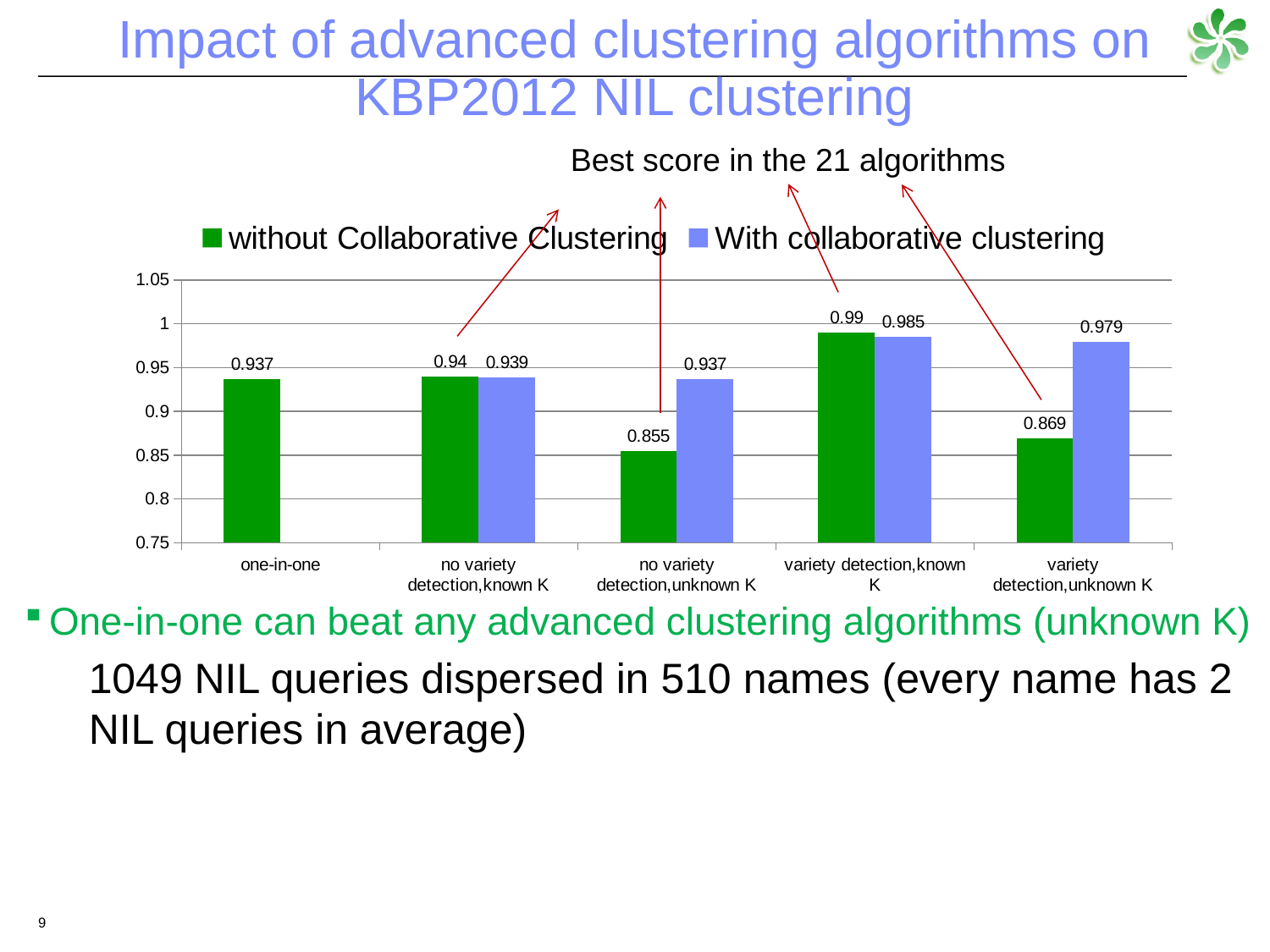
What is the value for no variety detection,unknown K with collaborative clustering? 0.937 How many series does the legend list? 2 How many categories are shown on the x axis? 5 Which category has the highest value without Collaborative Clustering? variety detection,known K What is the difference between the with and without collaborative clustering values for variety detection,unknown K? 0.11 What is the value for one-in-one without Collaborative Clustering? 0.937 Which category has the lowest value without Collaborative Clustering? no variety detection,unknown K Which colour represents the 'With collaborative clustering' series? blue Is the value for variety detection,known K without Collaborative Clustering greater or less than 0.95? greater For no variety detection,unknown K, which is larger: the value with collaborative clustering or without? With collaborative clustering What is the value for variety detection,unknown K without Collaborative Clustering? 0.869 What kind of chart is shown on the slide? bar chart